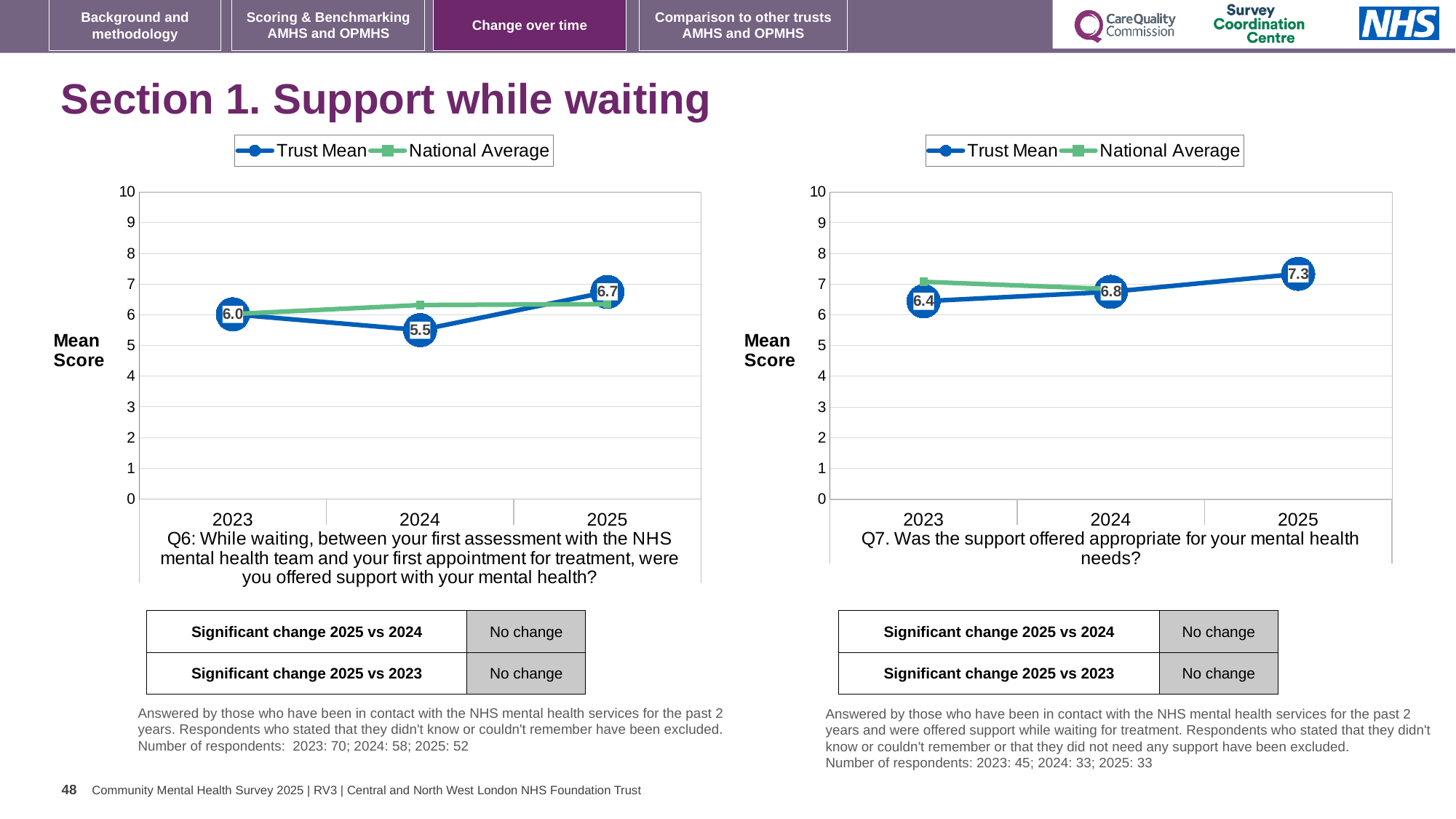
In the right chart (Q7), which year has the highest Trust Mean? 2025 In the right chart (Q7), does the Trust Mean rise or fall from 2023 to 2025? rise How many series does the legend of the left chart (Q6) list? 2 In the right chart (Q7), is the Trust Mean higher in 2024 or 2025? 2025 In the left chart (Q6), what is the difference between the Trust Mean for 2025 and 2024? 1.2 In the right chart (Q7), what is the difference between the Trust Mean for 2025 and 2023? 0.9 In the left chart (Q6), which year has the lowest Trust Mean? 2024 In the right chart (Q7), is the National Average for 2023 greater or less than 6? greater In the left chart (Q6), what is the Trust Mean for 2025? 6.7 In the right chart (Q7), what is the Trust Mean for 2023? 6.4 In the left chart (Q6), what is the Trust Mean for 2024? 5.5 In the right chart (Q7), what is the Trust Mean for 2025? 7.3